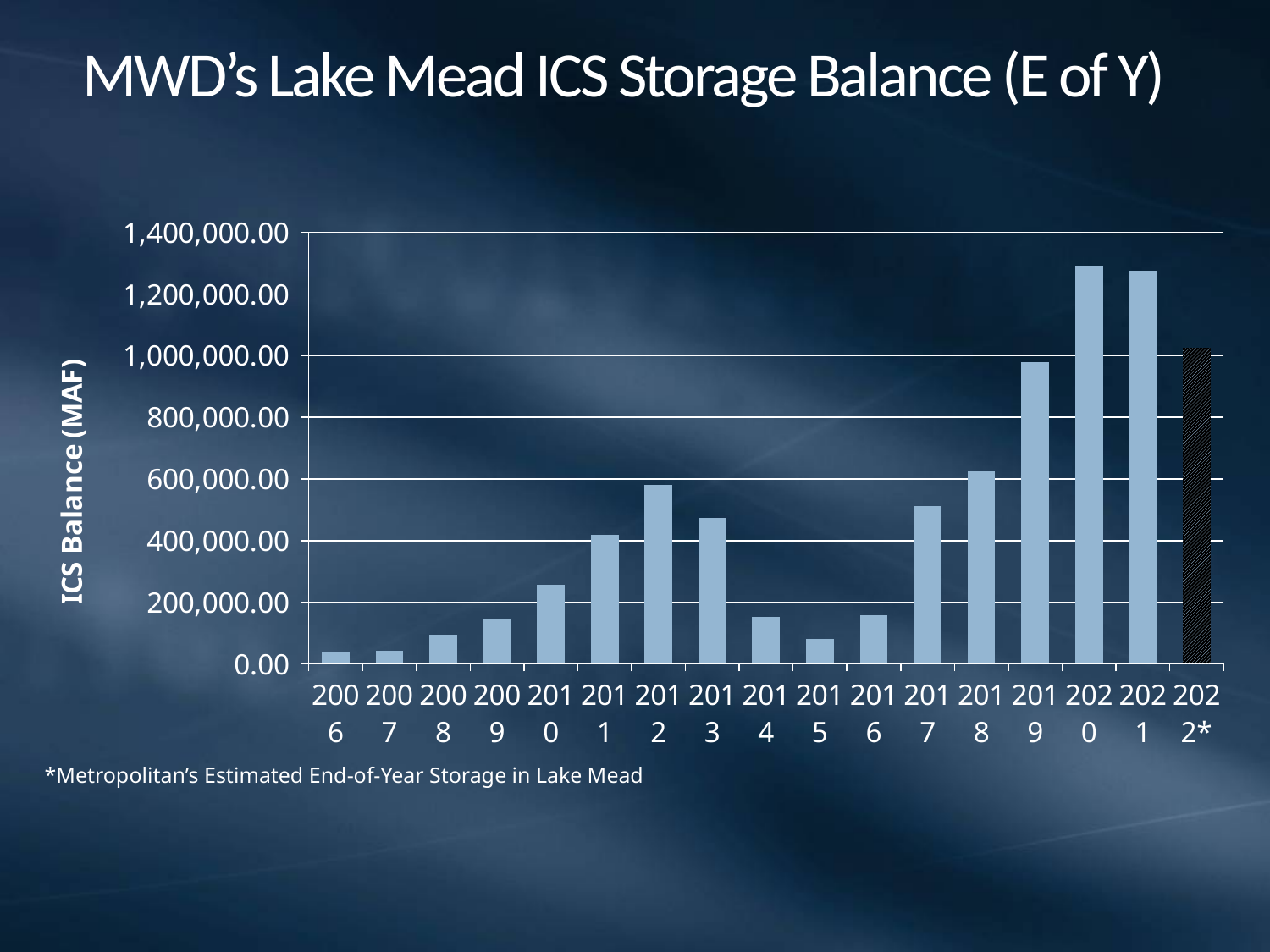
What is the title of the chart? MWD's Lake Mead ICS Storage Balance (E of Y) Which year has the larger value, 2018 or 2019? 2019 What is the label on the vertical axis? ICS Balance (MAF) Is the value for 2022* greater or less than 1,200,000.00? less Do the values rise or fall from 2017 to 2020? rise Is the value for 2019 greater or less than 800,000.00? greater What kind of chart is shown on the slide? bar chart Is the value for 2012 greater or less than 400,000.00? greater How many years (bars) are plotted on the chart? 17 Which year has the larger value, 2012 or 2013? 2012